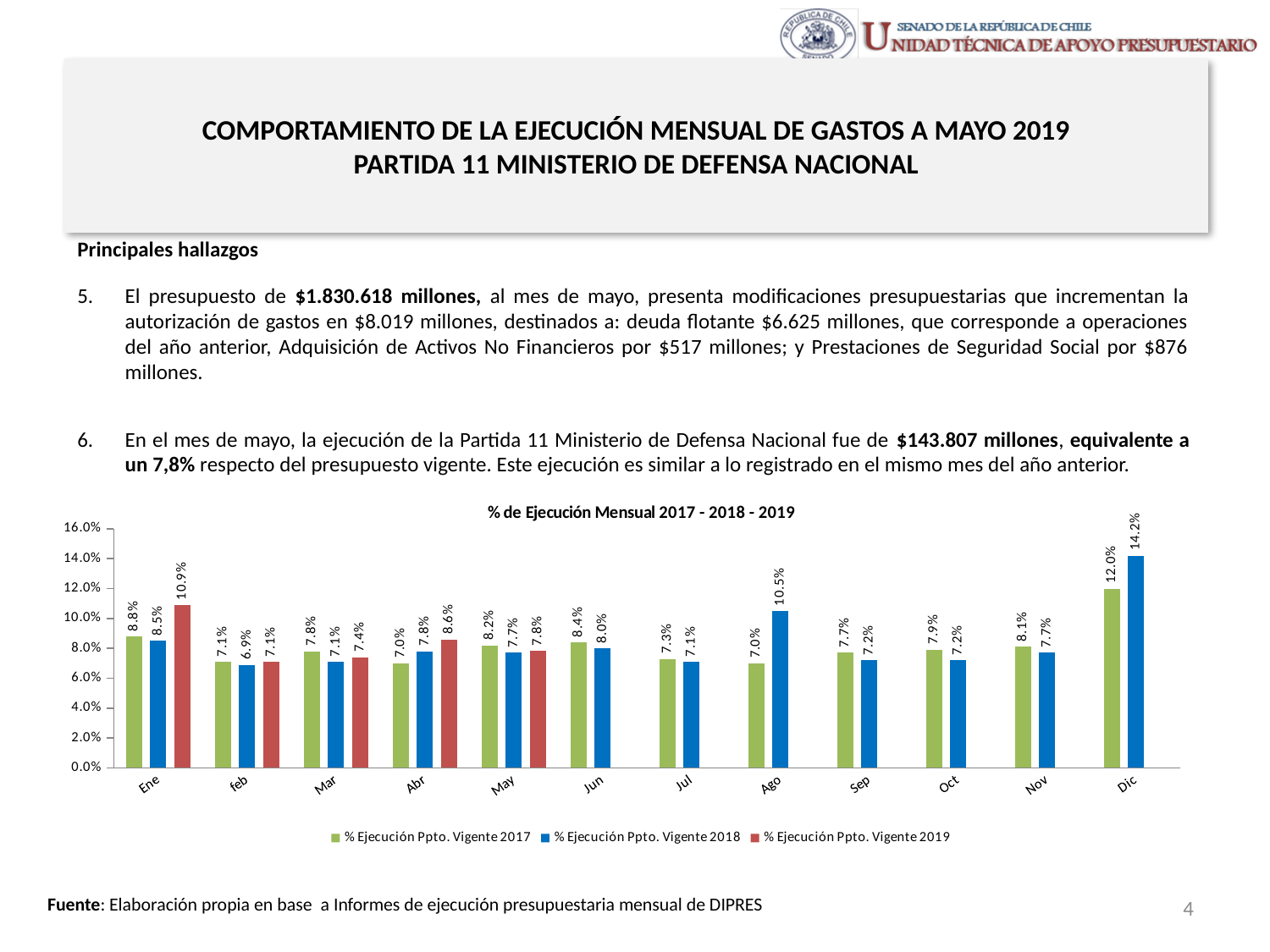
Which month has the highest value for % Ejecución Ppto. Vigente 2019? Ene What is the value for % Ejecución Ppto. Vigente 2019 in Ene? 10.9% How many months are shown on the x axis? 12 What is the difference between the 2018 and 2017 values in Dic? 2.2% Is the value for % Ejecución Ppto. Vigente 2017 in Dic greater or less than 10.0%? greater What is the value for % Ejecución Ppto. Vigente 2017 in May? 8.2% Which month has the highest value for % Ejecución Ppto. Vigente 2018? Dic What kind of chart is shown on the slide? Bar chart Which month has the lowest value for % Ejecución Ppto. Vigente 2018? feb How many series does the legend list? 3 In Ago, which series has the larger value: % Ejecución Ppto. Vigente 2017 or % Ejecución Ppto. Vigente 2018? % Ejecución Ppto. Vigente 2018 What is the value for % Ejecución Ppto. Vigente 2018 in Dic? 14.2%